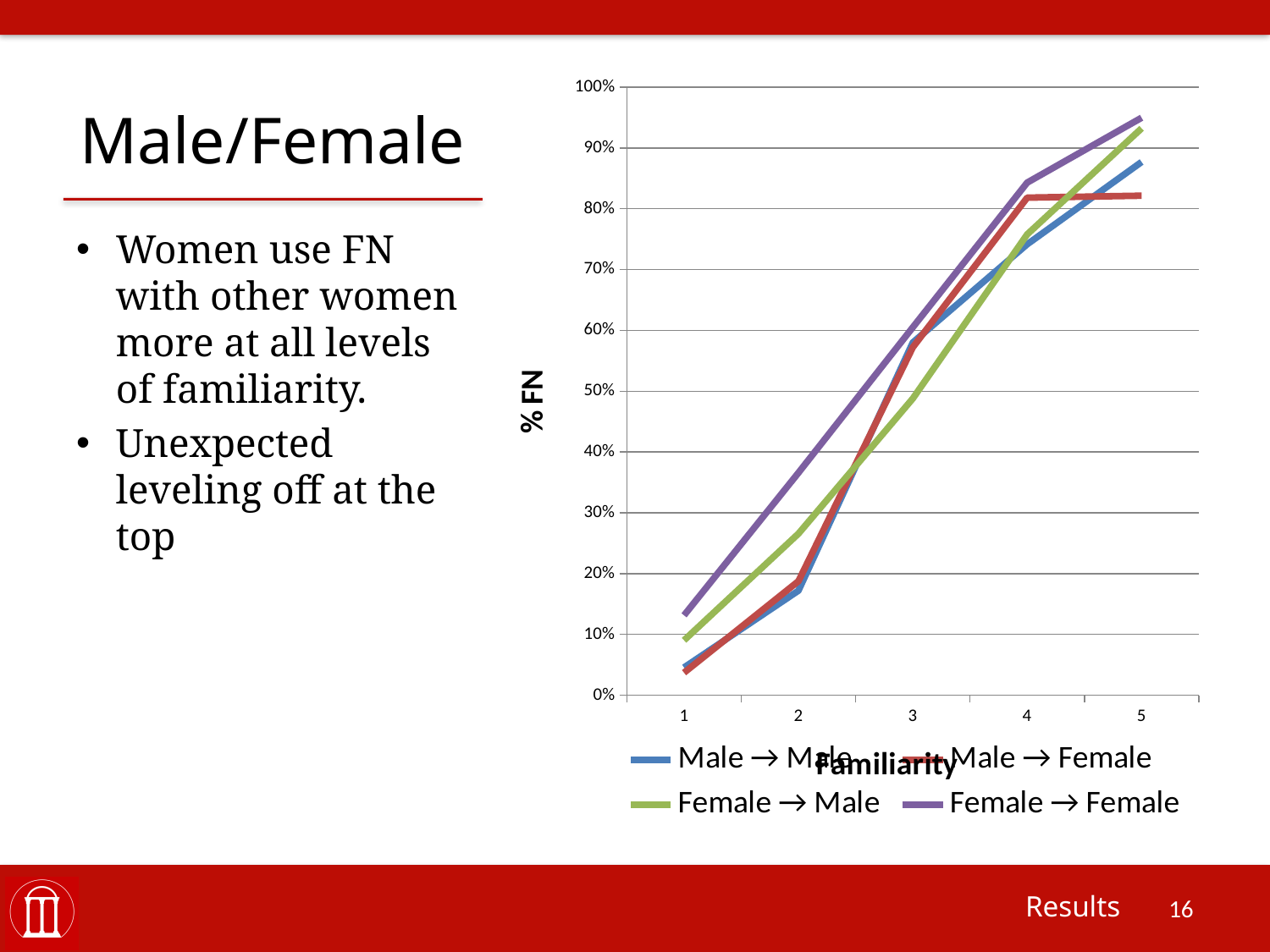
What kind of chart is shown on the slide? line chart Is the value for Male → Male at familiarity level 1 greater or less than 10%? less At familiarity level 2, which is larger: Female → Male or Male → Male? Female → Male Which series has the lowest % FN at familiarity level 5? Male → Female How many familiarity levels are plotted along the x axis? 5 Is the value for Male → Male at familiarity level 2 greater or less than 20%? less Does the Female → Female series rise or fall as familiarity increases from 1 to 5? rise At familiarity level 4, which is larger: Female → Female or Male → Male? Female → Female Which series has the highest % FN at familiarity level 1? Female → Female How many series does the chart's legend list? 4 What is the title of the chart's y axis? % FN Is the value for Female → Female at familiarity level 4 greater or less than 80%? greater